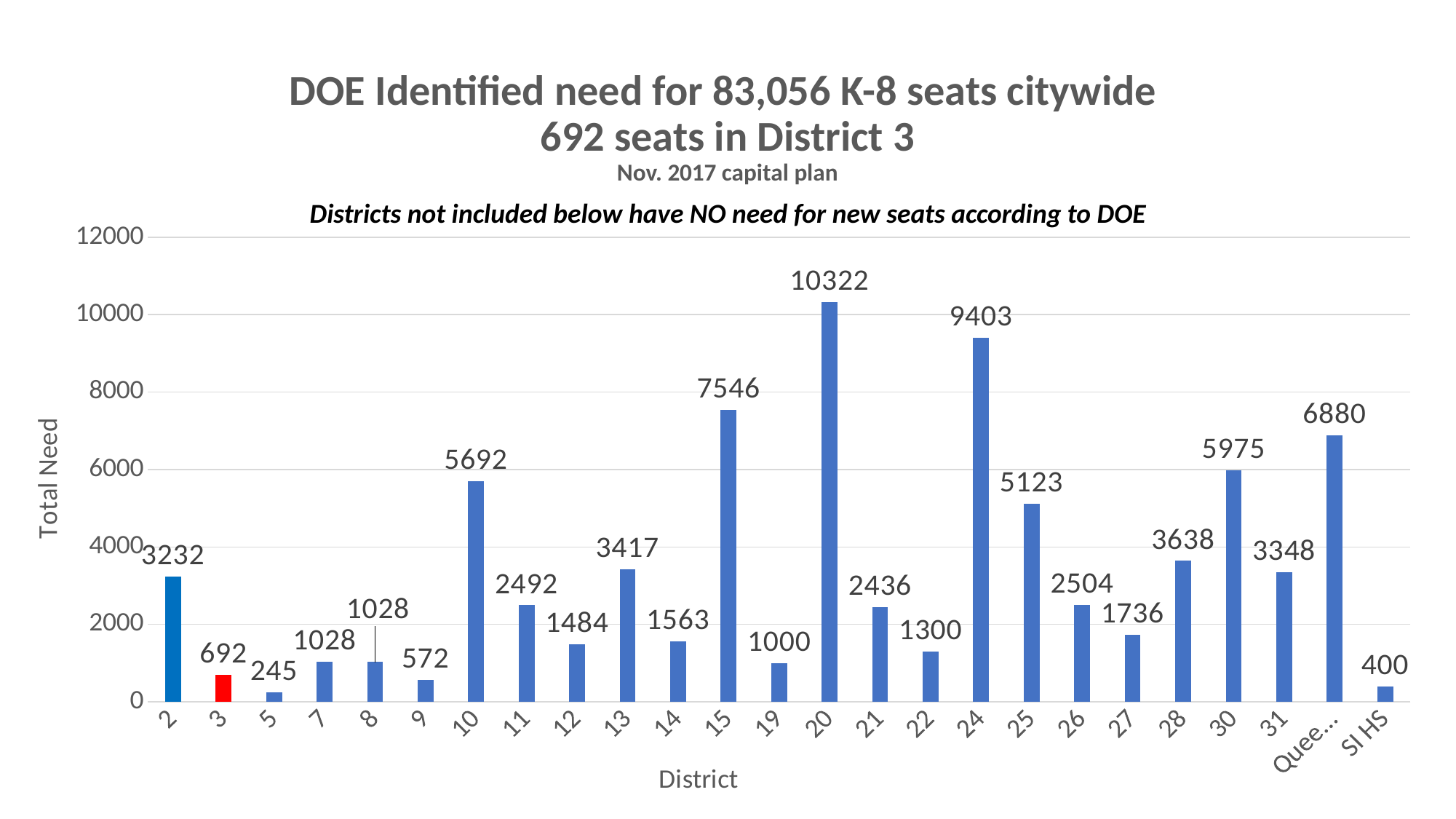
What is the difference in total need between District 2 and District 3? 2540 Is the value for District 28 greater or less than 4000? less Which has a larger total need, District 10 or District 30? District 30 What is the total need value for District 15? 7546 Which district has the lowest total need? 5 What is the difference in total need between District 20 and District 24? 919 What is the total need value for District 3? 692 Which district's bar is coloured red in the chart? 3 Which district has the highest total need? 20 What kind of chart is shown on the slide? bar chart What is the total need value for SI HS? 400 How many districts are shown on the x axis of the chart? 25